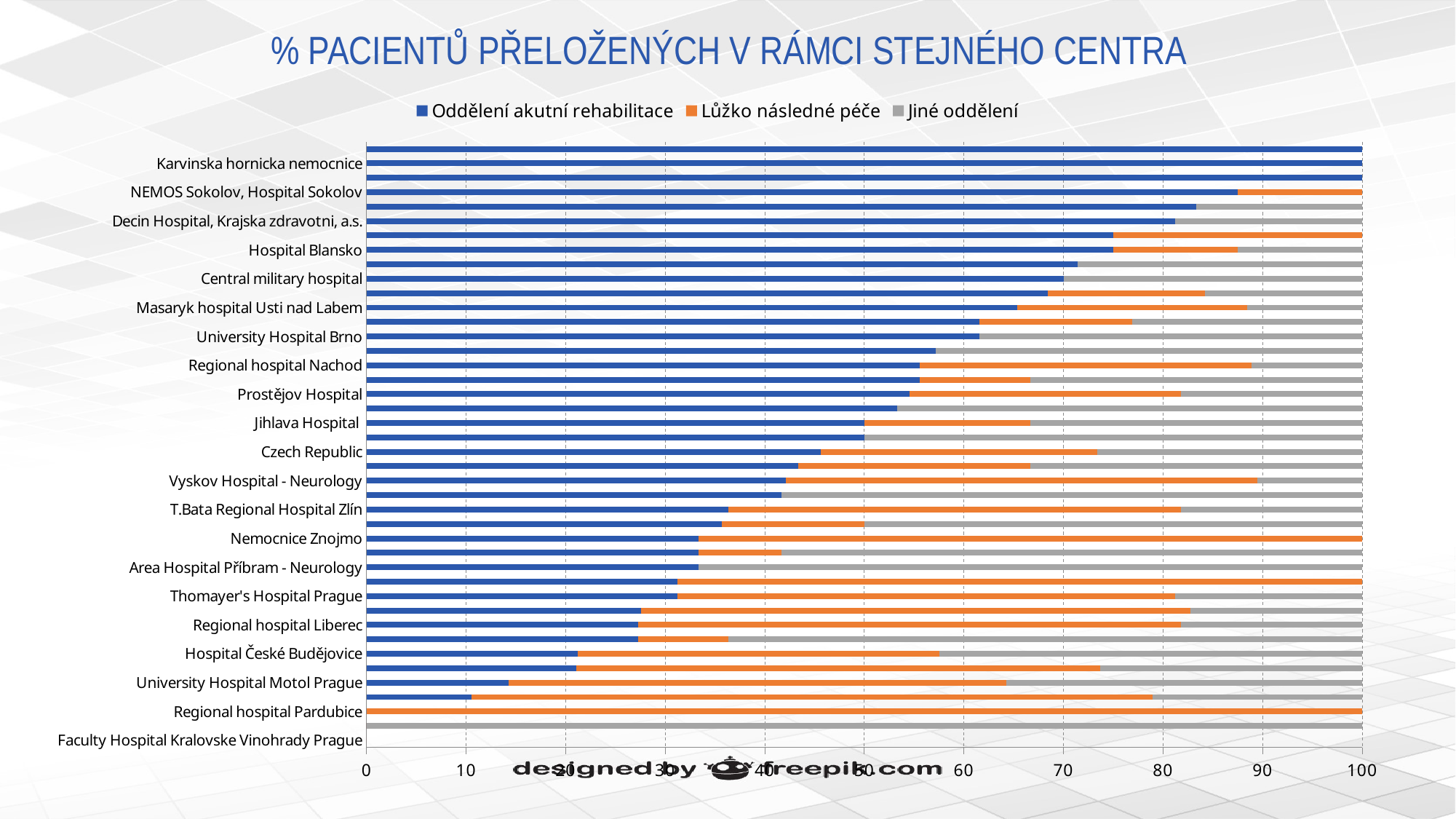
What kind of chart is shown on the slide? Stacked bar chart Is the Oddělení akutní rehabilitace value for Nemocnice Znojmo greater or less than 40? less How many series does the legend list? 3 Going from the top of the chart to the bottom, do the Oddělení akutní rehabilitace values rise or fall? fall Is the Lůžko následné péče value for Regional hospital Pardubice greater or less than 90? greater Is the Oddělení akutní rehabilitace value for Decin Hospital, Krajska zdravotni, a.s. greater or less than 70? greater Which has a larger Oddělení akutní rehabilitace value, Czech Republic or University Hospital Motol Prague? Czech Republic Which series is shown in orange in the legend? Lůžko následné péče What is the title of the chart? % PACIENTŮ PŘELOŽENÝCH V RÁMCI STEJNÉHO CENTRA Which has a larger Oddělení akutní rehabilitace value, Karvinska hornicka nemocnice or Faculty Hospital Kralovske Vinohrady Prague? Karvinska hornicka nemocnice